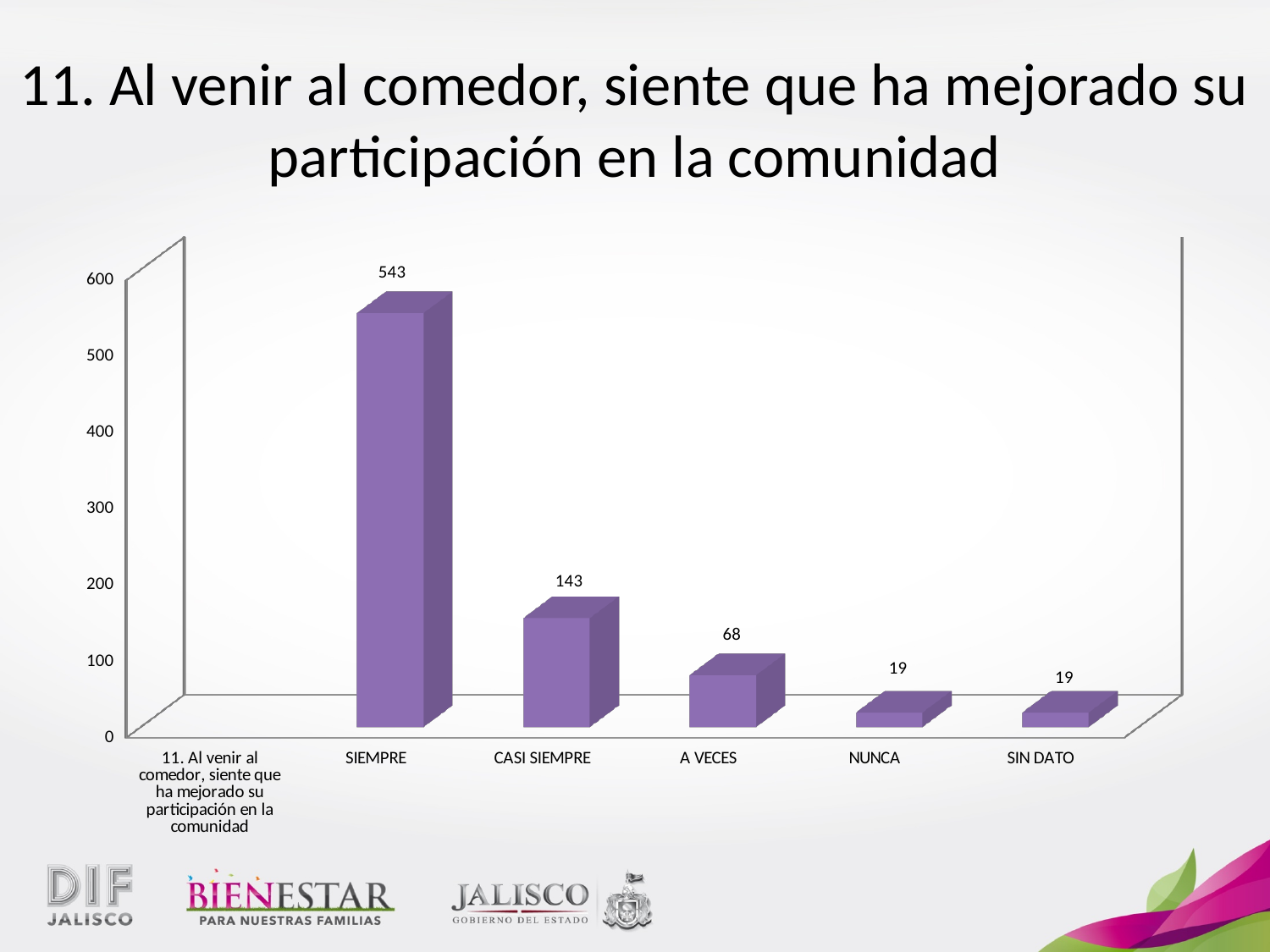
How many bars are plotted in the chart? 5 What is the value for CASI SIEMPRE? 143 What is the difference between the values for CASI SIEMPRE and A VECES? 75 Is the value for SIEMPRE greater or less than 500? greater What kind of chart is shown on the slide? Bar chart What is the value for SIEMPRE? 543 What is the value for A VECES? 68 Which category has the highest value? SIEMPRE Which is larger, the value for A VECES or the value for NUNCA? A VECES What is the value for NUNCA? 19 What is the difference between the values for SIEMPRE and CASI SIEMPRE? 400 What is the value for SIN DATO? 19